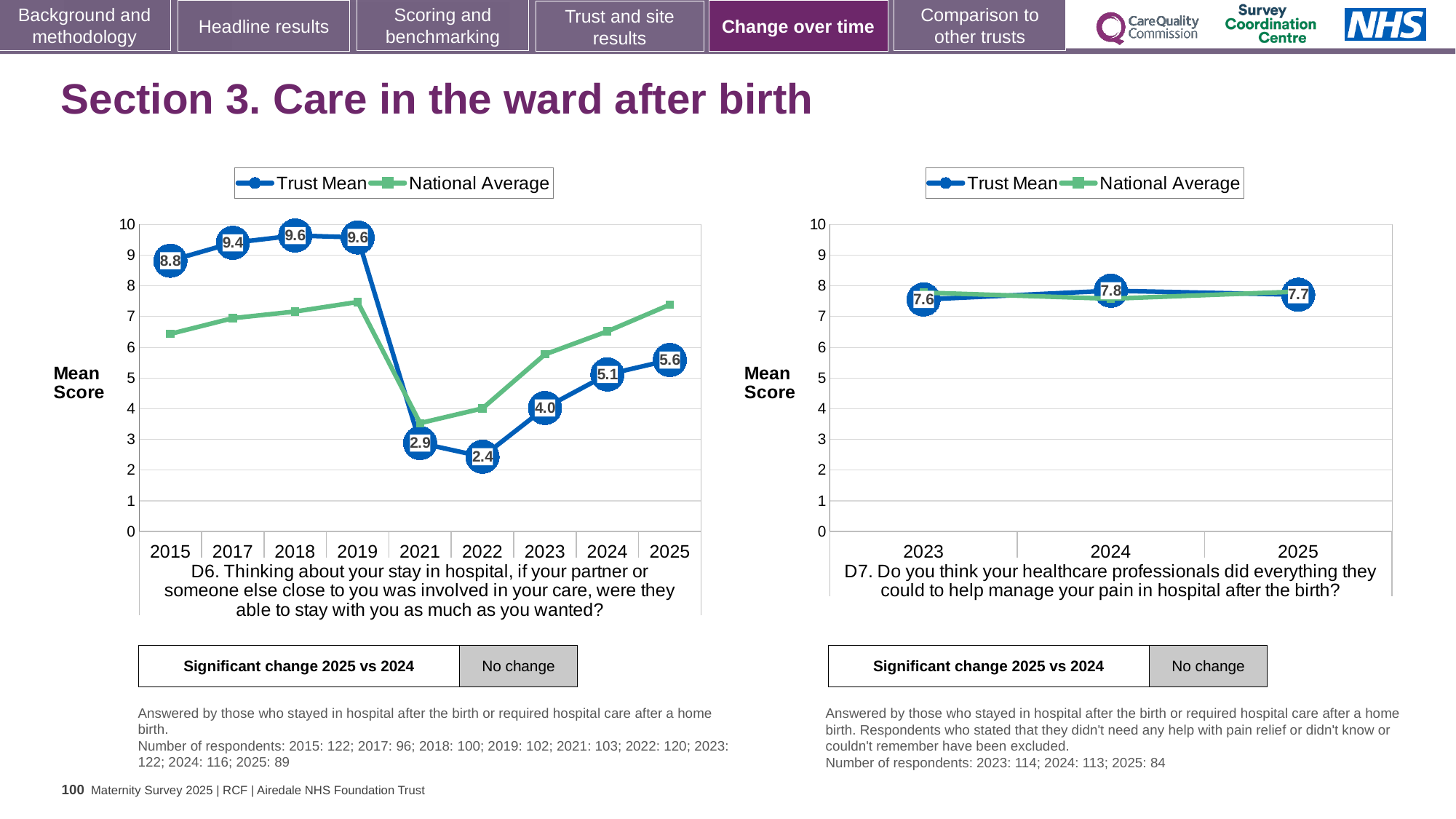
How many series does the legend of the D7 chart on the right list? 2 In the D6 chart on the left, is the Trust Mean or the National Average higher in 2025? National Average In the D6 chart on the left, what is the Trust Mean for 2022? 2.4 In the D6 chart on the left, does the Trust Mean rise or fall from 2022 to 2025? Rise In the D6 chart on the left, which year has the lowest Trust Mean? 2022 In the D6 chart on the left, what is the Trust Mean for 2015? 8.8 In the D7 chart on the right, what is the Trust Mean for 2024? 7.8 In the D7 chart on the right, which year has the lowest Trust Mean? 2023 In the D6 chart on the left, is the National Average for 2015 greater or less than 7? less What kind of chart is the D7 chart on the right? Line chart In the D6 chart on the left, what is the difference between the Trust Mean for 2025 and 2024? 0.5 How many years are plotted on the x axis of the D6 chart on the left? 9